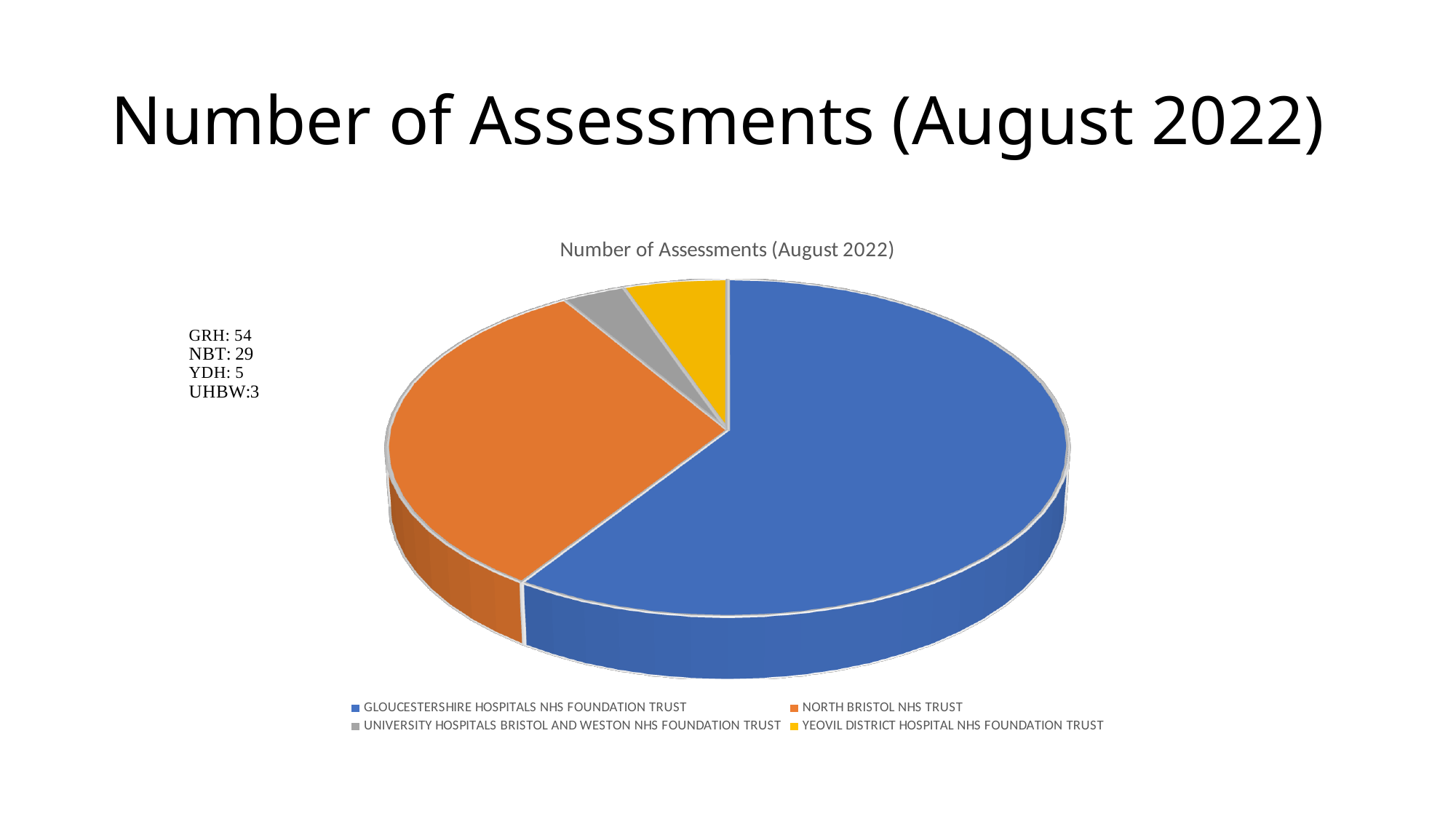
What is the chart's title? Number of Assessments (August 2022) According to the text on the slide, how many assessments did NBT have? 29 According to the text on the slide, how many assessments did UHBW have? 3 How many slices does the pie chart have? 4 How many entries does the legend list? 4 What is the difference between the GRH and NBT assessment counts? 25 Which colour represents North Bristol NHS Trust in the pie chart? orange According to the text on the slide, how many assessments did YDH have? 5 According to the text on the slide, how many assessments did GRH have? 54 Which trust has the largest slice of the pie? Gloucestershire Hospitals NHS Foundation Trust Which trust has the smallest slice of the pie? University Hospitals Bristol and Weston NHS Foundation Trust What type of chart is shown on the slide? pie chart